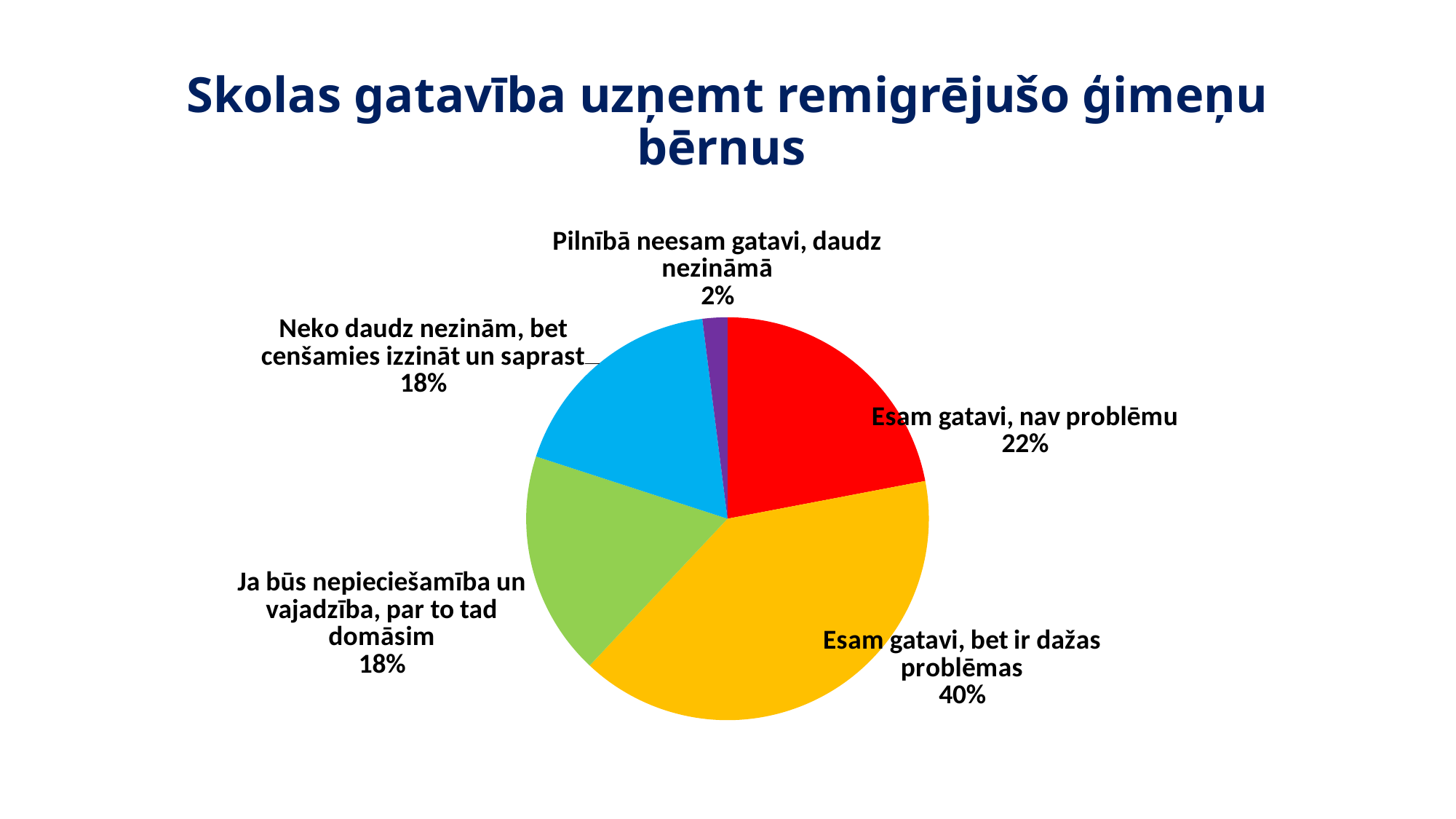
Which category has the largest slice of the pie? Esam gatavi, bet ir dažas problēmas What share of the pie is 'Pilnībā neesam gatavi, daudz nezināmā'? 2% What share of the pie is 'Esam gatavi, bet ir dažas problēmas'? 40% How many slices does the pie chart have? 5 What kind of chart is shown on the slide? pie chart What is the difference in percentage points between 'Esam gatavi, bet ir dažas problēmas' and 'Esam gatavi, nav problēmu'? 18 What colour is the slice for 'Esam gatavi, bet ir dažas problēmas'? yellow Which category has the smallest slice of the pie? Pilnībā neesam gatavi, daudz nezināmā What share of the pie is 'Neko daudz nezinām, bet cenšamies izzināt un saprast'? 18% What is the title of the slide? Skolas gatavība uzņemt remigrējušo ģimeņu bērnus Which is larger: 'Esam gatavi, nav problēmu' or 'Ja būs nepieciešamība un vajadzība, par to tad domāsim'? Esam gatavi, nav problēmu